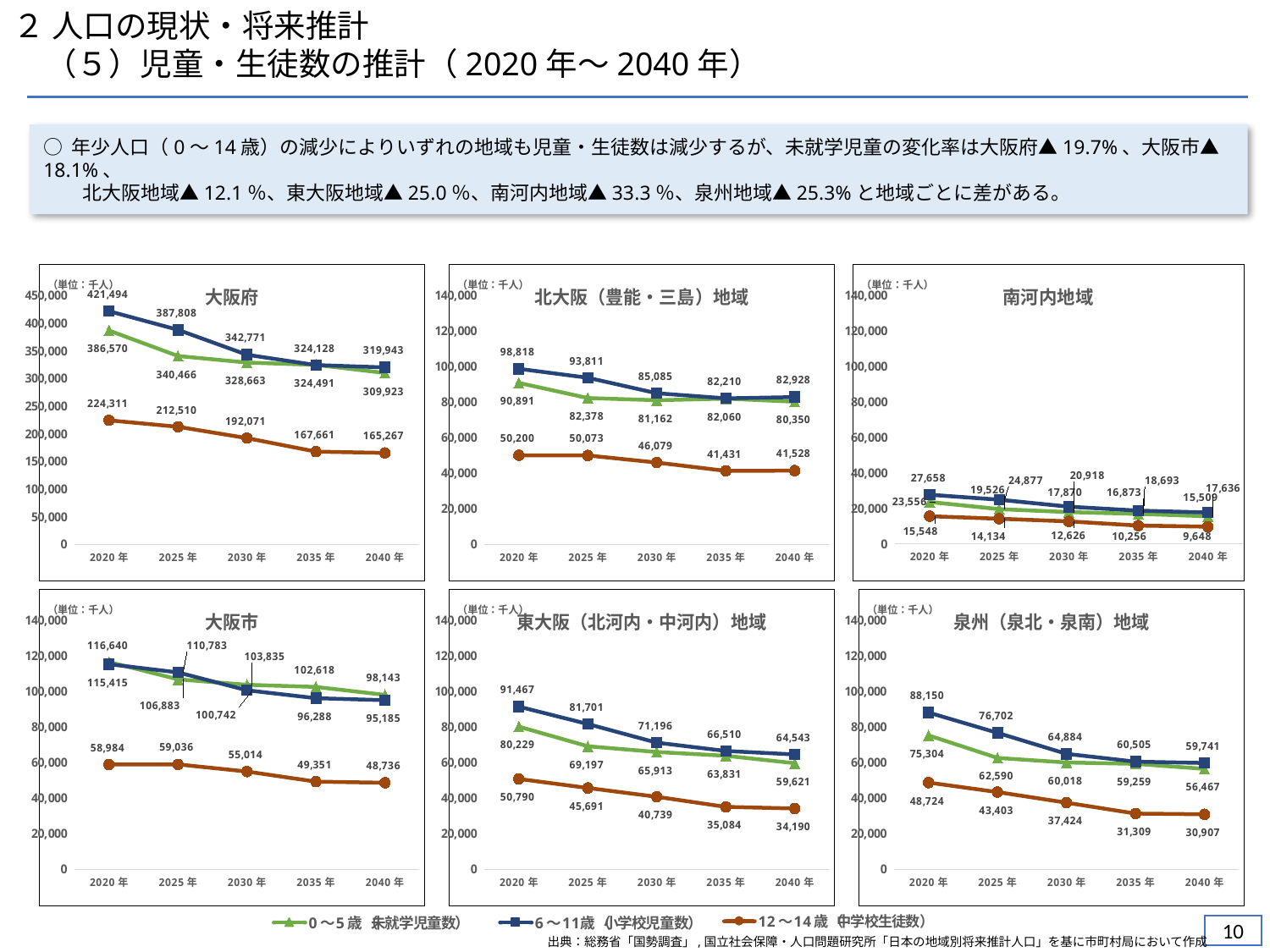
How many years are plotted on the x axis of the 南河内地域 chart? 5 In the 泉州（泉北・泉南）地域 chart, which is larger in 2020年: 6～11歳 or 0～5歳? 6～11歳 In the 大阪府 chart, what is the value for 12～14歳 in 2020年? 224,311 In the 北大阪（豊能・三島）地域 chart, what is the value for 0～5歳 in 2025年? 82,378 In the 南河内地域 chart, what is the value for 12～14歳 in 2040年? 9,648 In the 大阪市 chart, what is the difference between the 6～11歳 values for 2020年 and 2040年? 20,230 In the 泉州（泉北・泉南）地域 chart, what is the value for 12～14歳 in 2035年? 31,309 What kind of chart is the 大阪府 chart? Line chart In the 東大阪（北河内・中河内）地域 chart, does the 6～11歳 series rise or fall from 2020年 to 2040年? Fall How many series does the shared legend at the bottom of the slide list? 3 In the 東大阪（北河内・中河内）地域 chart, which year has the lowest value for 12～14歳? 2040年 In the 大阪府 chart, what is the value for 6～11歳 in 2040年? 319,943